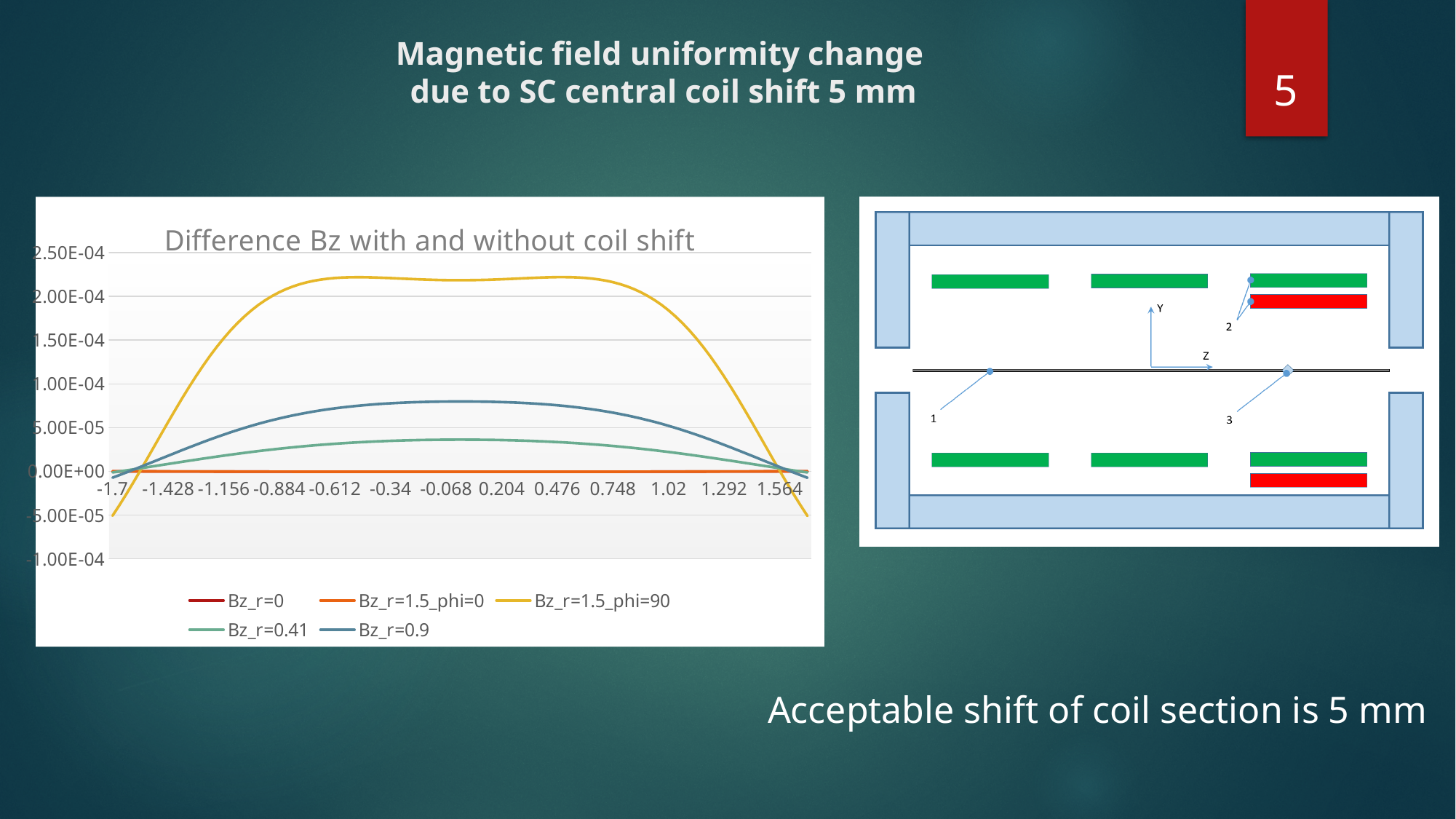
Is the peak value of the Bz_r=0.41 series greater or less than 5.00E-05? less How does the Bz_r=1.5_phi=90 series behave from x = -1.7 to x = 1.564? It rises to a plateau near the centre and then falls Which series is drawn with the yellow line? Bz_r=1.5_phi=90 What is the title of the chart? Difference Bz with and without coil shift How many series does the chart legend list? 5 Is the value of the Bz_r=1.5_phi=90 series at x = -1.7 greater or less than 0.00E+00? less Near the centre of the x axis, which series has the larger value: Bz_r=0.9 or Bz_r=0.41? Bz_r=0.9 How many tick labels are shown on the x axis of the chart? 13 Which series reaches the highest value on the chart? Bz_r=1.5_phi=90 Is the peak value of the Bz_r=1.5_phi=90 series greater or less than 2.00E-04? greater What kind of chart is shown on the slide? Line chart